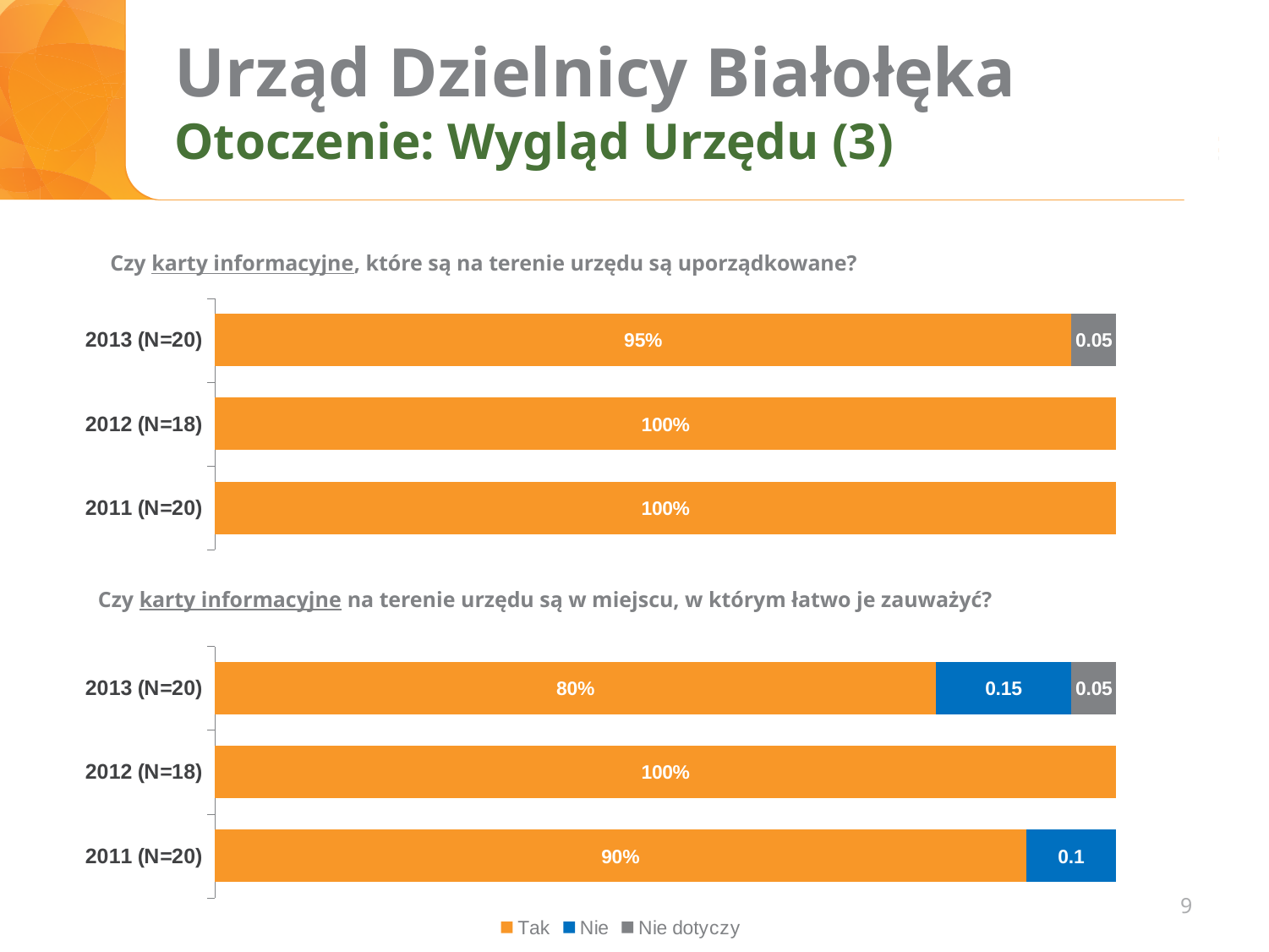
In the bottom chart, what is the 'Tak' value for 2013 (N=20)? 80% How many series does the legend list? 3 What kind of chart is the bottom chart? bar chart In the bottom chart, which year has the highest 'Tak' value? 2012 (N=18) In the bottom chart, what is the difference between the 'Tak' values for 2011 (N=20) and 2013 (N=20)? 10% In the top chart, what is the 'Tak' value for 2012 (N=18)? 100% In the top chart, what is the 'Nie dotyczy' value for 2013 (N=20)? 0.05 In the bottom chart, what is the 'Nie' value for 2011 (N=20)? 0.1 In the top chart, is the 'Tak' value for 2013 (N=20) larger or smaller than the 'Tak' value for 2011 (N=20)? smaller In the top chart, what is the 'Tak' value for 2013 (N=20)? 95% In the bottom chart, which year has the lowest 'Tak' value? 2013 (N=20) In the bottom chart, what is the 'Nie' value for 2013 (N=20)? 0.15